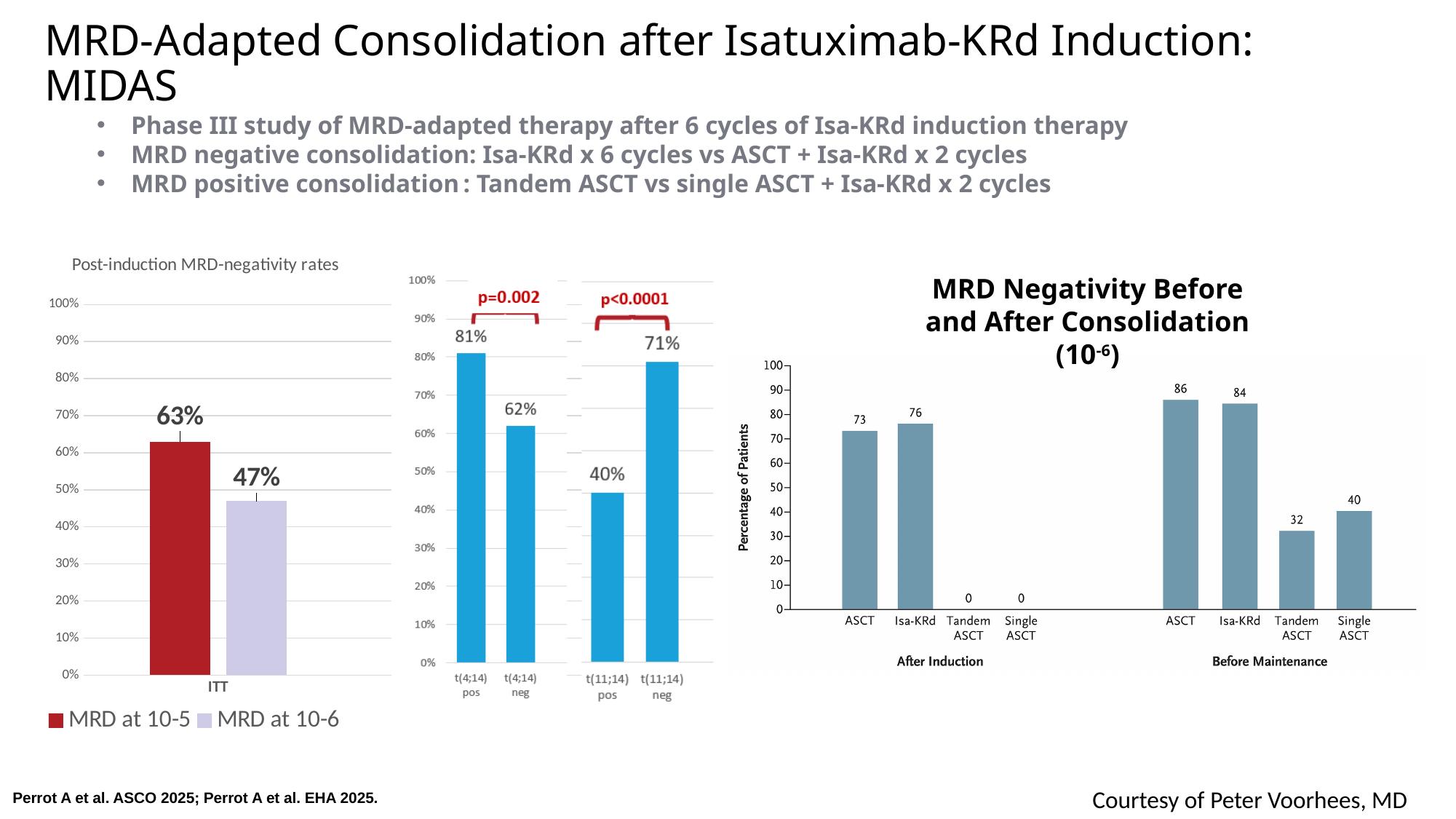
What kind of chart is the 'MRD Negativity Before and After Consolidation' chart? Bar chart In the 'MRD Negativity Before and After Consolidation' chart, which category has the highest value? ASCT (Before Maintenance) In the 'MRD Negativity Before and After Consolidation' chart, what is the value for Isa-KRd before maintenance? 84 In the 'Post-induction MRD-negativity rates' chart, how many series does the legend list? 2 In the middle chart, what is the difference between t(4;14) pos and t(4;14) neg? 19% In the 'Post-induction MRD-negativity rates' chart, what is the MRD-negativity rate at 10-5 for ITT? 63% In the 'Post-induction MRD-negativity rates' chart, what is the difference between the MRD at 10-5 and MRD at 10-6 values? 16% In the middle chart, which is larger, t(11;14) pos or t(11;14) neg? t(11;14) neg In the 'MRD Negativity Before and After Consolidation' chart, what is the difference between Single ASCT and Tandem ASCT before maintenance? 8 In the middle chart, what is the value for t(11;14) pos? 40% In the 'Post-induction MRD-negativity rates' chart, what is the MRD-negativity rate at 10-6 for ITT? 47% In the middle chart, what is the value for t(4;14) pos? 81%